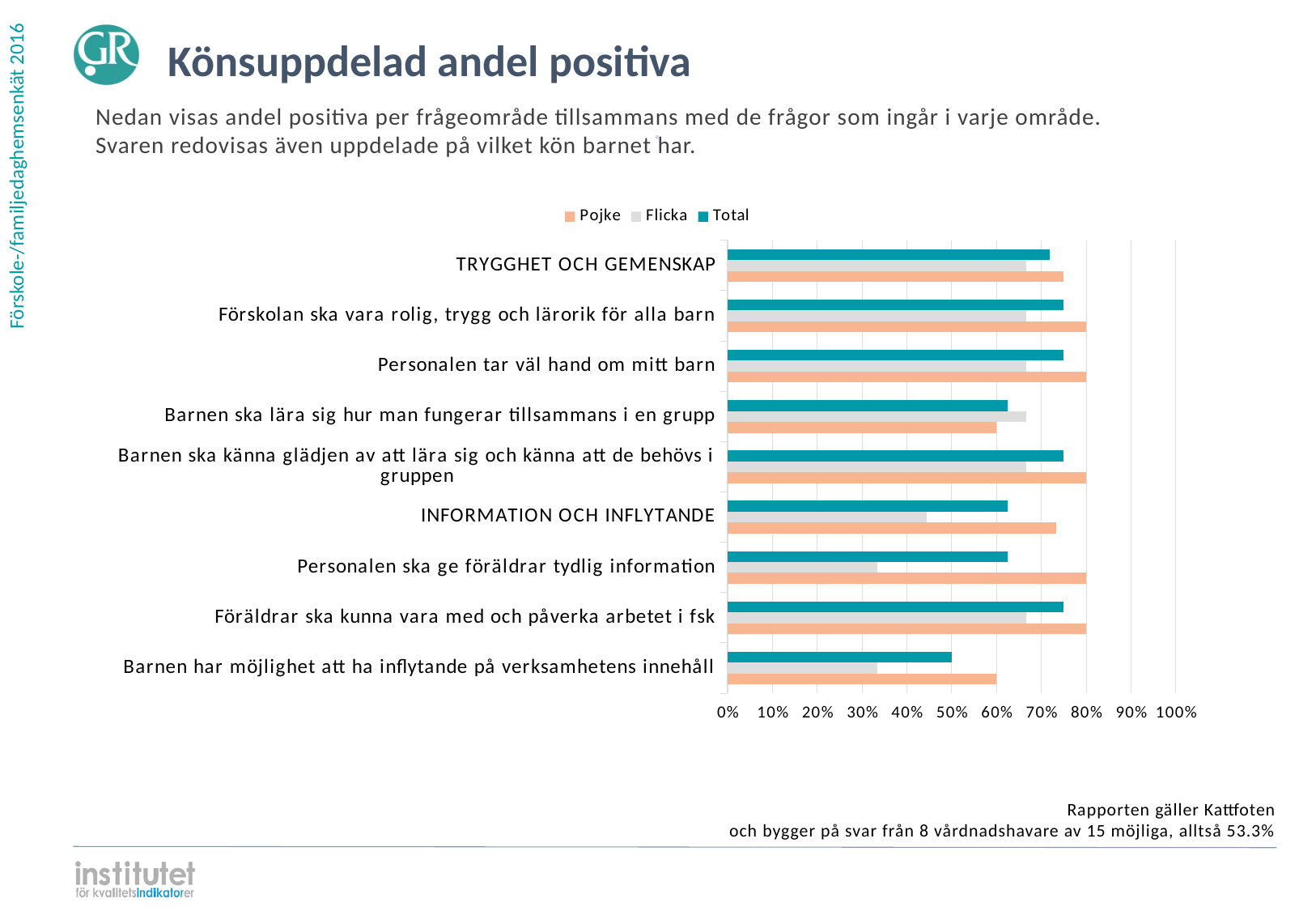
Is the Total value for 'Barnen ska lära sig hur man fungerar tillsammans i en grupp' greater or less than 70%? less How many categories are shown on the chart? 9 How many series does the legend list? 3 Is the Pojke value for 'Föräldrar ska kunna vara med och påverka arbetet i fsk' greater or less than 70%? greater Is the Pojke value for TRYGGHET OCH GEMENSKAP greater or less than 70%? greater Which category has the lowest Total value? Barnen har möjlighet att ha inflytande på verksamhetens innehåll Which series is shown in orange in the legend? Pojke For INFORMATION OCH INFLYTANDE, which is larger, the Pojke value or the Flicka value? Pojke What kind of chart is shown on the slide? bar chart